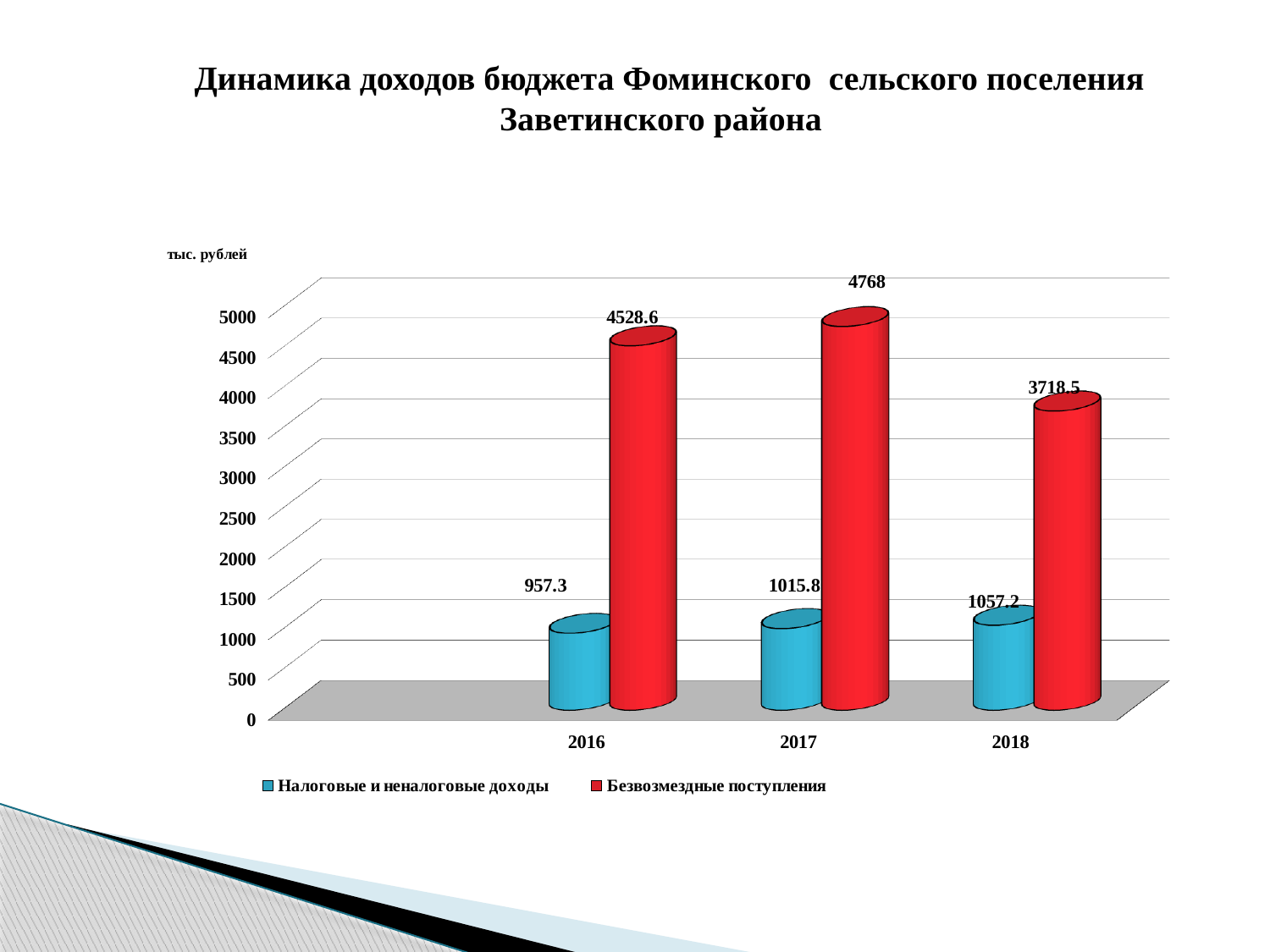
What is the value of Безвозмездные поступления for 2017? 4768 Do the values for Налоговые и неналоговые доходы rise or fall from 2016 to 2018? Rise What is the value of Безвозмездные поступления for 2018? 3718.5 What is the difference between Безвозмездные поступления in 2017 and 2018? 1049.5 How many series does the legend list? 2 In which year is Безвозмездные поступления highest? 2017 What is the value of Налоговые и неналоговые доходы for 2016? 957.3 How many years are shown on the x axis? 3 In which year is Налоговые и неналоговые доходы lowest? 2016 Which is larger in 2016: Налоговые и неналоговые доходы or Безвозмездные поступления? Безвозмездные поступления What is the value of Налоговые и неналоговые доходы for 2018? 1057.2 What kind of chart is shown on the slide? Bar chart